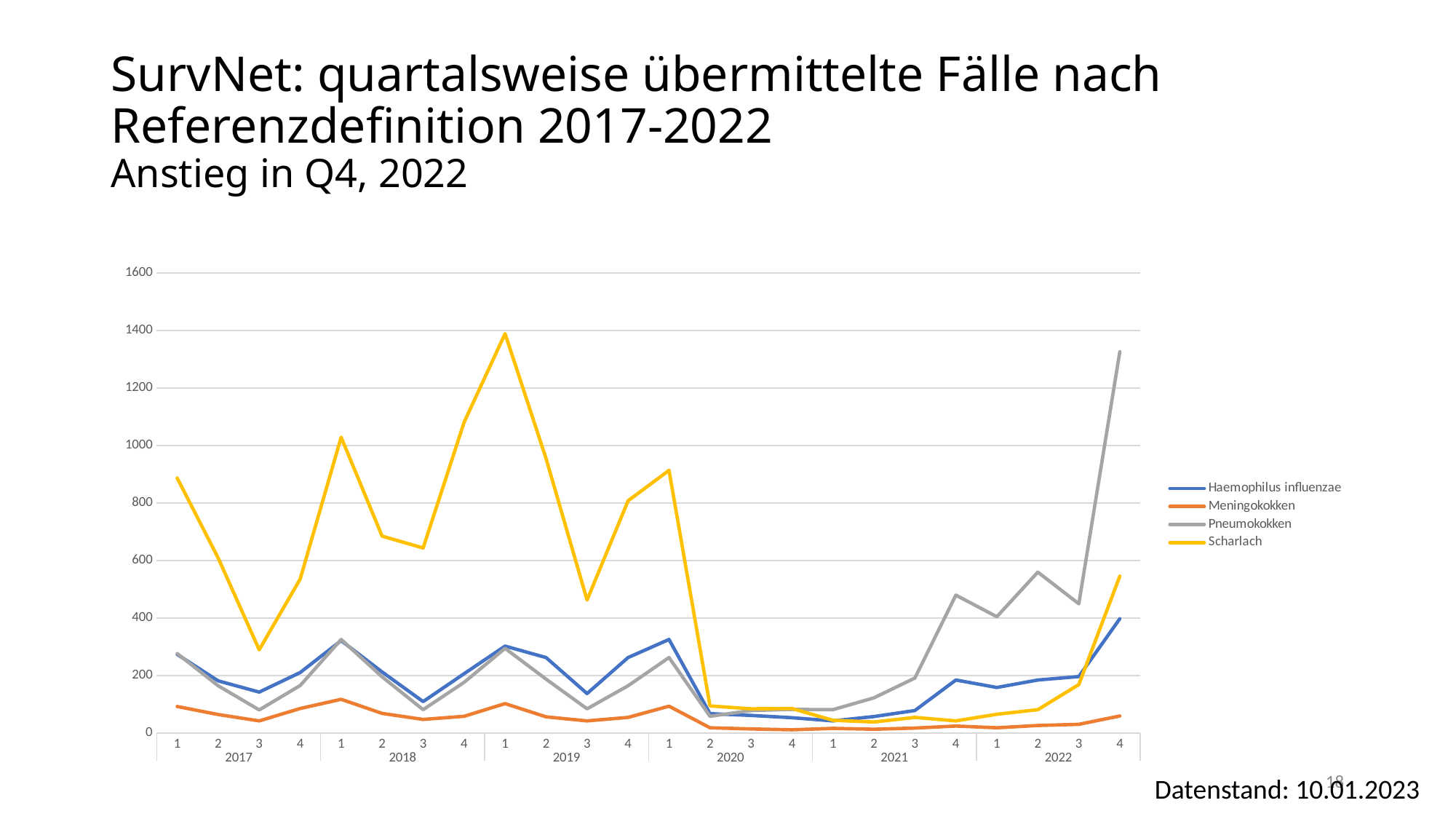
How many series does the legend list? 4 What kind of chart is shown on the slide? line chart Which colour is used for the Scharlach series in the legend? yellow How many quarterly data points are plotted along the x axis? 24 Is the value for Scharlach in quarter 1 of 2019 greater or less than 1200? greater Is the value for Scharlach in quarter 3 of 2017 greater or less than 400? less Which series has the highest value in quarter 4 of 2022? Pneumokokken In which quarter does Scharlach reach its highest value? Quarter 1 of 2019 Which is larger in quarter 4 of 2021, Pneumokokken or Haemophilus influenzae? Pneumokokken Which series has the lowest values across the whole period? Meningokokken Is the value for Pneumokokken in quarter 4 of 2022 greater or less than 1200? greater Does the Pneumokokken line rise or fall from quarter 3 of 2022 to quarter 4 of 2022? rise